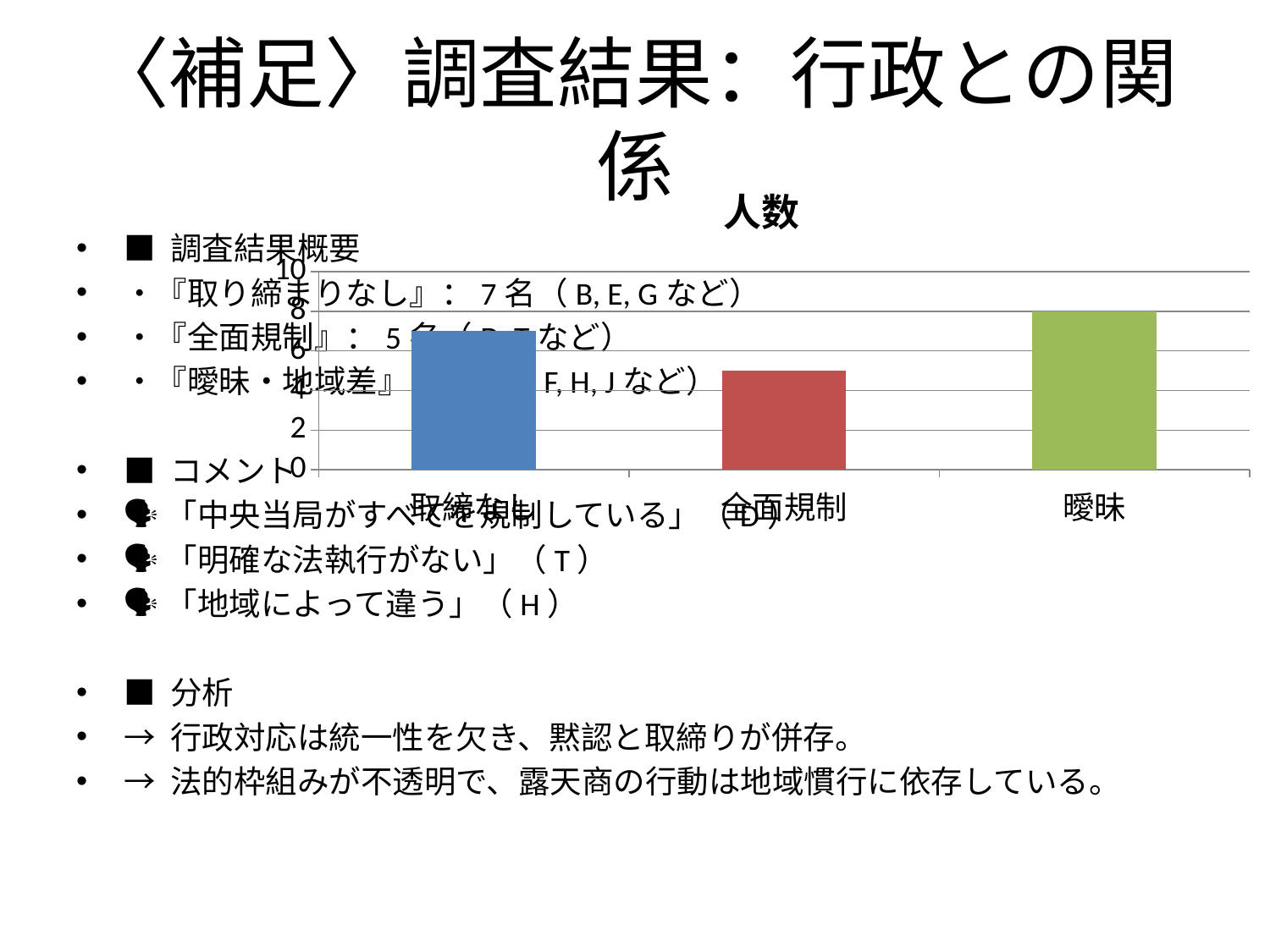
Is the value for 取締なし greater or less than 6? greater Which is larger, the value for 取締なし or the value for 全面規制? 取締なし Is the value for 曖昧 greater or less than 6? greater Which is larger, the value for 曖昧 or the value for 全面規制? 曖昧 Is the value for 全面規制 greater or less than 6? less How many categories are plotted in the chart? 3 What kind of chart is shown on the slide? bar chart What is the title of the chart? 人数 Which category has the lowest bar in the chart? 全面規制 What colour is the bar for 曖昧? green Which category has the highest bar in the chart? 曖昧